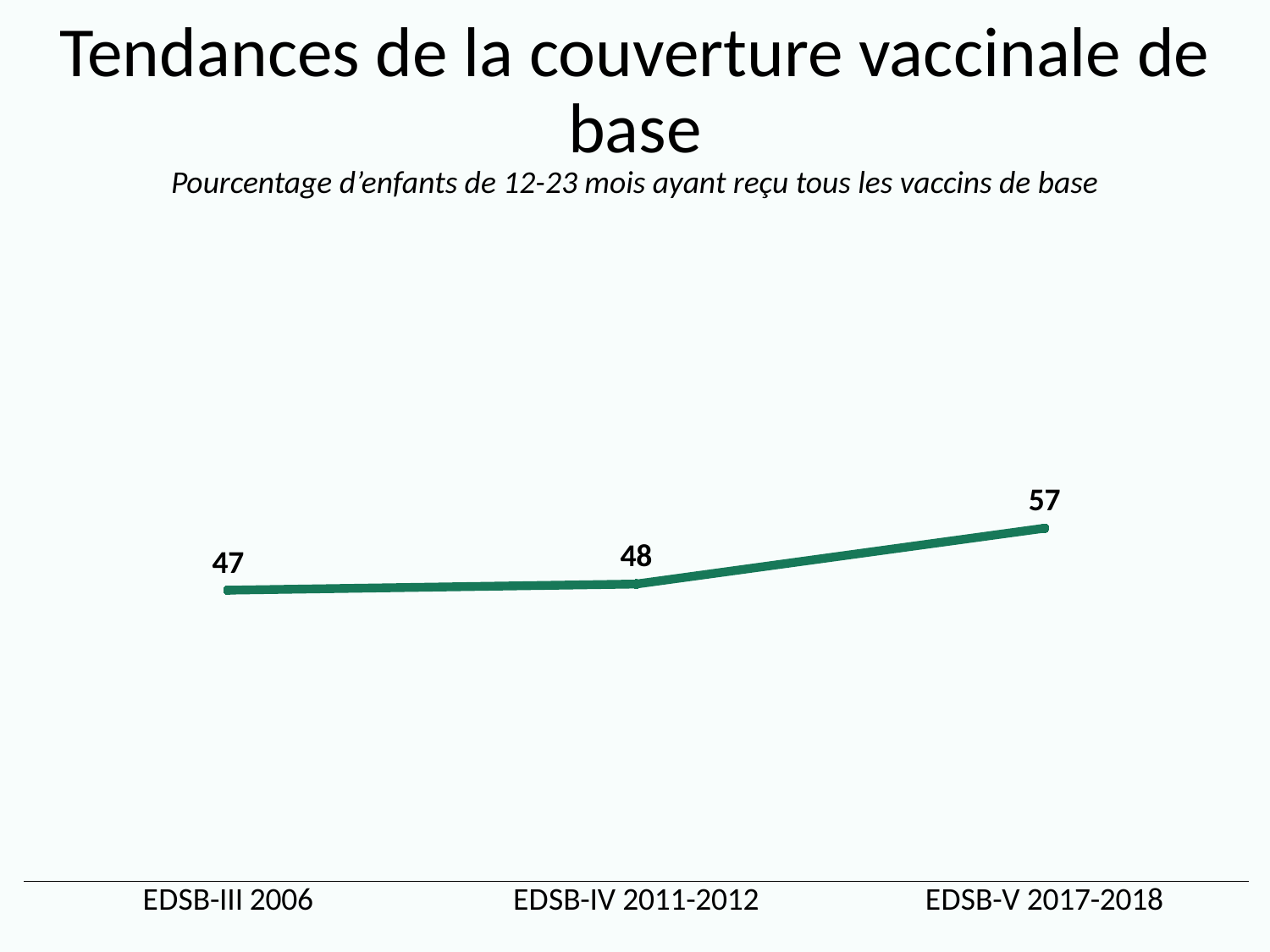
What is the value for EDSB-III 2006? 47 What is the value for EDSB-IV 2011-2012? 48 What is the difference between the values for EDSB-V 2017-2018 and EDSB-III 2006? 10 What is the value for EDSB-V 2017-2018? 57 What is the difference between the values for EDSB-V 2017-2018 and EDSB-IV 2011-2012? 9 What is the title of the chart? Tendances de la couverture vaccinale de base Which survey has the highest value? EDSB-V 2017-2018 How many data points are plotted on the chart? 3 Do the values rise or fall from EDSB-III 2006 to EDSB-V 2017-2018? rise Which survey has the lowest value? EDSB-III 2006 What kind of chart is shown on the slide? line chart Which is larger, the value for EDSB-IV 2011-2012 or EDSB-V 2017-2018? EDSB-V 2017-2018